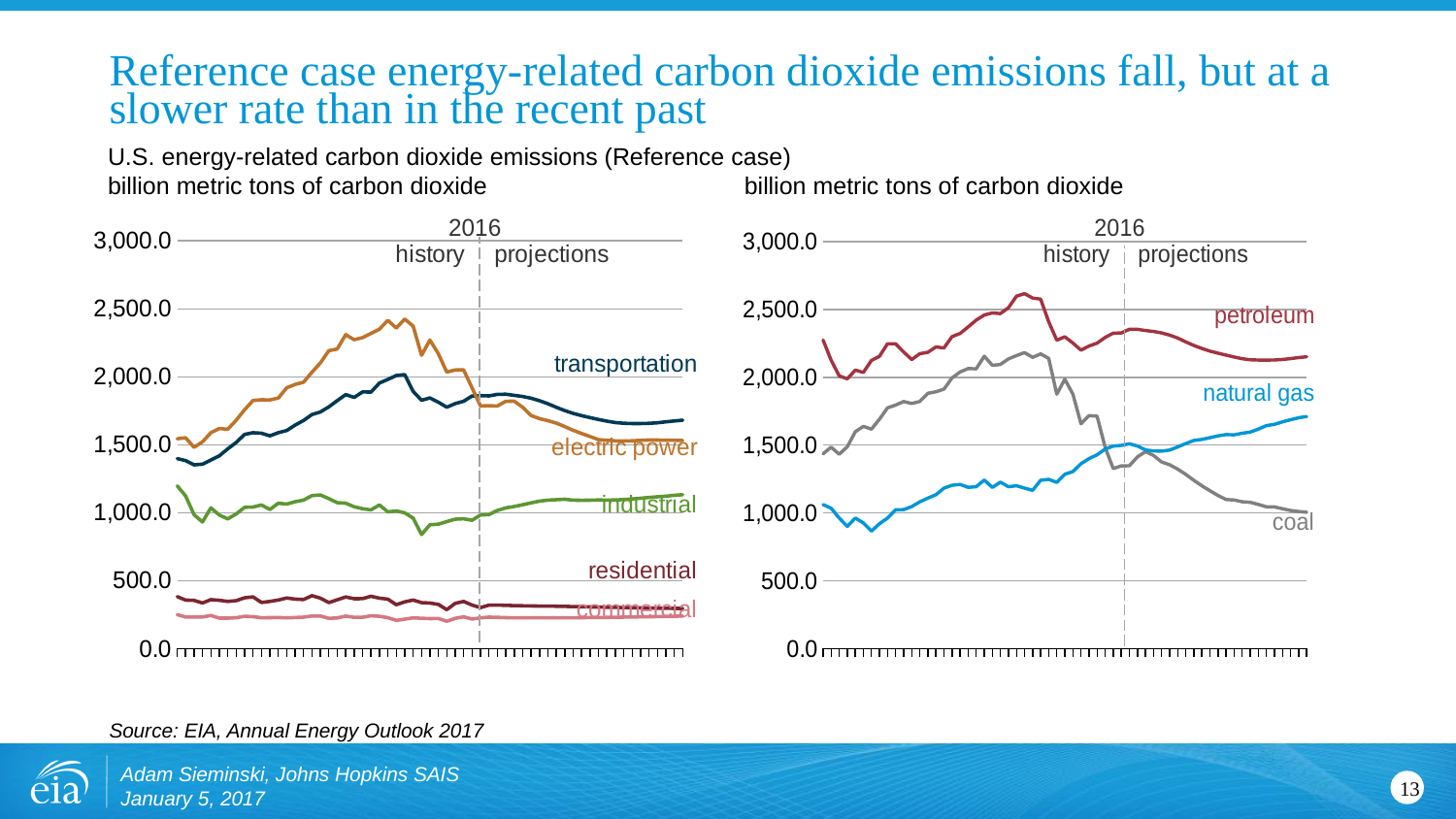
How many series are plotted on the left chart (by sector)? 5 On the left chart, is the peak value for electric power greater or less than 2,000.0? greater On the left chart, which sector has the highest emissions at the end of the projection period? transportation On the right chart, is the peak value for petroleum greater or less than 2,500.0? greater On the left chart, is the value for residential at the end of the projection period greater or less than 500.0? less How many series are plotted on the right chart (by fuel)? 3 Which year does the dashed vertical line separating history from projections mark on both charts? 2016 What kind of chart is the left chart on the slide? line chart On the left chart, which sector has the lowest emissions throughout the period? commercial On the right chart, at the end of the projection period, which is larger: natural gas or coal? natural gas On the right chart, do coal emissions rise or fall over the projection period? fall On the right chart, which fuel has the highest emissions at the end of the projection period? petroleum